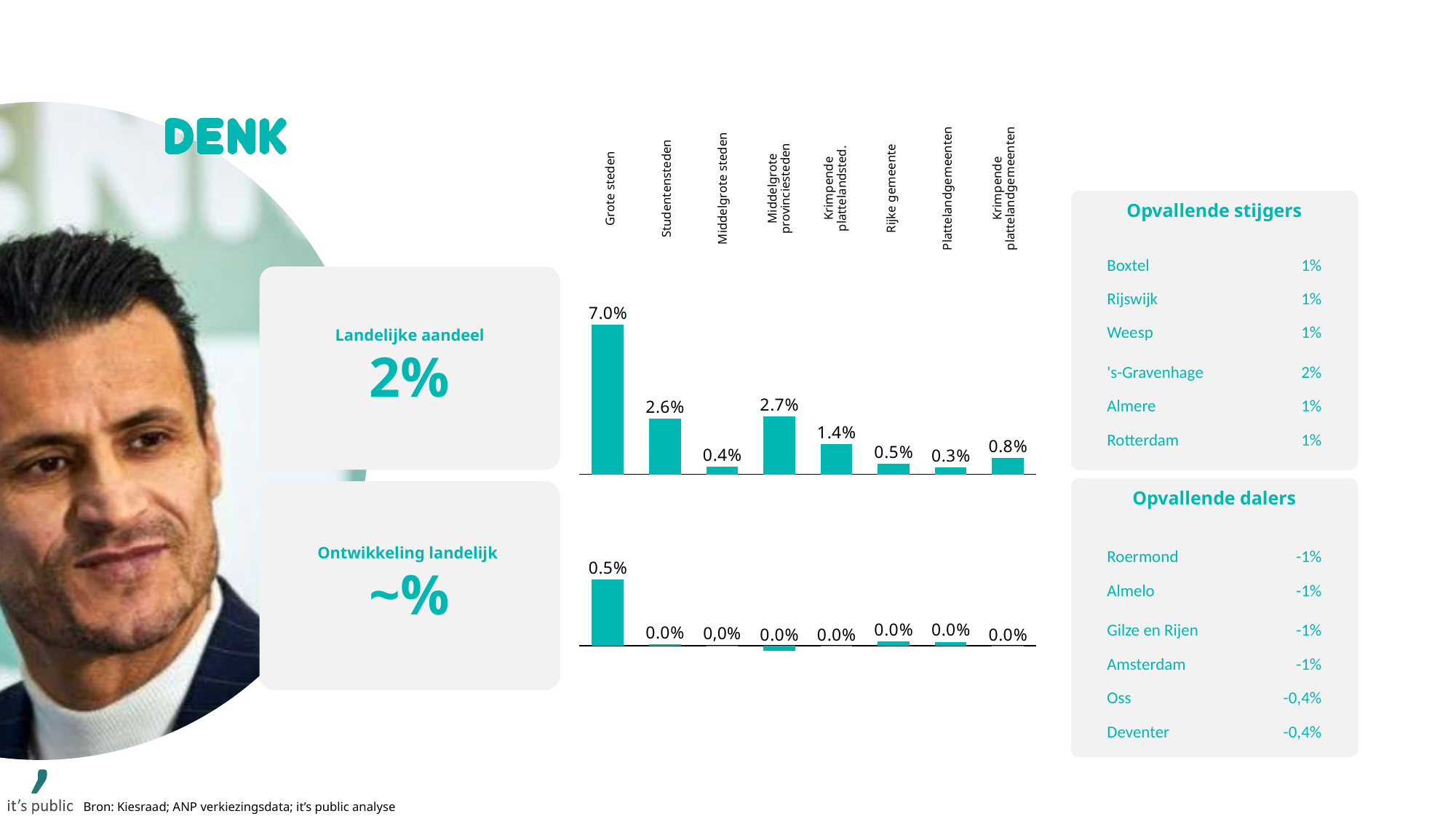
In the top chart, what is the difference between the values for Grote steden and Studentensteden? 4.4% In the top chart, which is larger: the value for Studentensteden or the value for Middelgrote provinciesteden? Middelgrote provinciesteden In the top chart, which category has the highest value? Grote steden In the top chart, which category has the lowest value? Plattelandgemeenten In the top chart, what is the value for Middelgrote provinciesteden? 2.7% In the top chart, what is the value for Grote steden? 7.0% In the bottom chart, what is the value for Rijke gemeente? 0.0% In the bottom chart, what is the value for Grote steden? 0.5% What kind of chart is the bottom chart? Bar chart How many categories are shown in the top chart? 8 In the bottom chart, which category has the highest value? Grote steden In the top chart, what is the value for Krimpende plattelandgemeenten? 0.8%